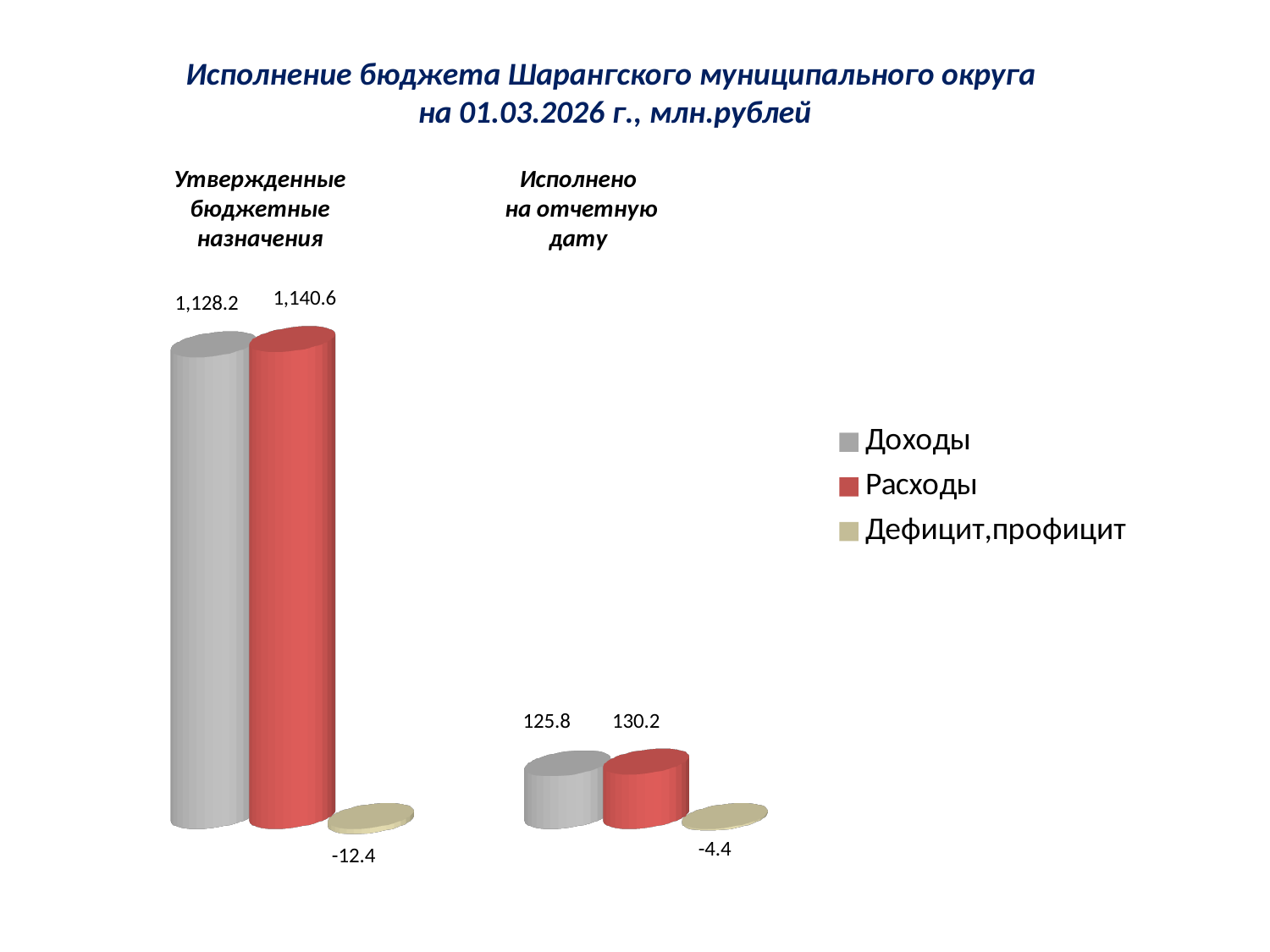
Which is larger for Исполнено на отчетную дату: Доходы or Расходы? Расходы What is the value of Расходы for Исполнено на отчетную дату? 130.2 What is the value of Расходы for Утвержденные бюджетные назначения? 1,140.6 What is the value of Доходы for Исполнено на отчетную дату? 125.8 What is the value of Доходы for Утвержденные бюджетные назначения? 1,128.2 What is the difference between Расходы and Доходы for Утвержденные бюджетные назначения? 12.4 What is the difference between Расходы and Доходы for Исполнено на отчетную дату? 4.4 What is the value of Дефицит,профицит for Исполнено на отчетную дату? -4.4 How many series does the legend list? 3 What is the value of Дефицит,профицит for Утвержденные бюджетные назначения? -12.4 What kind of chart is shown on the slide? Bar chart How many categories are shown on the chart? 2